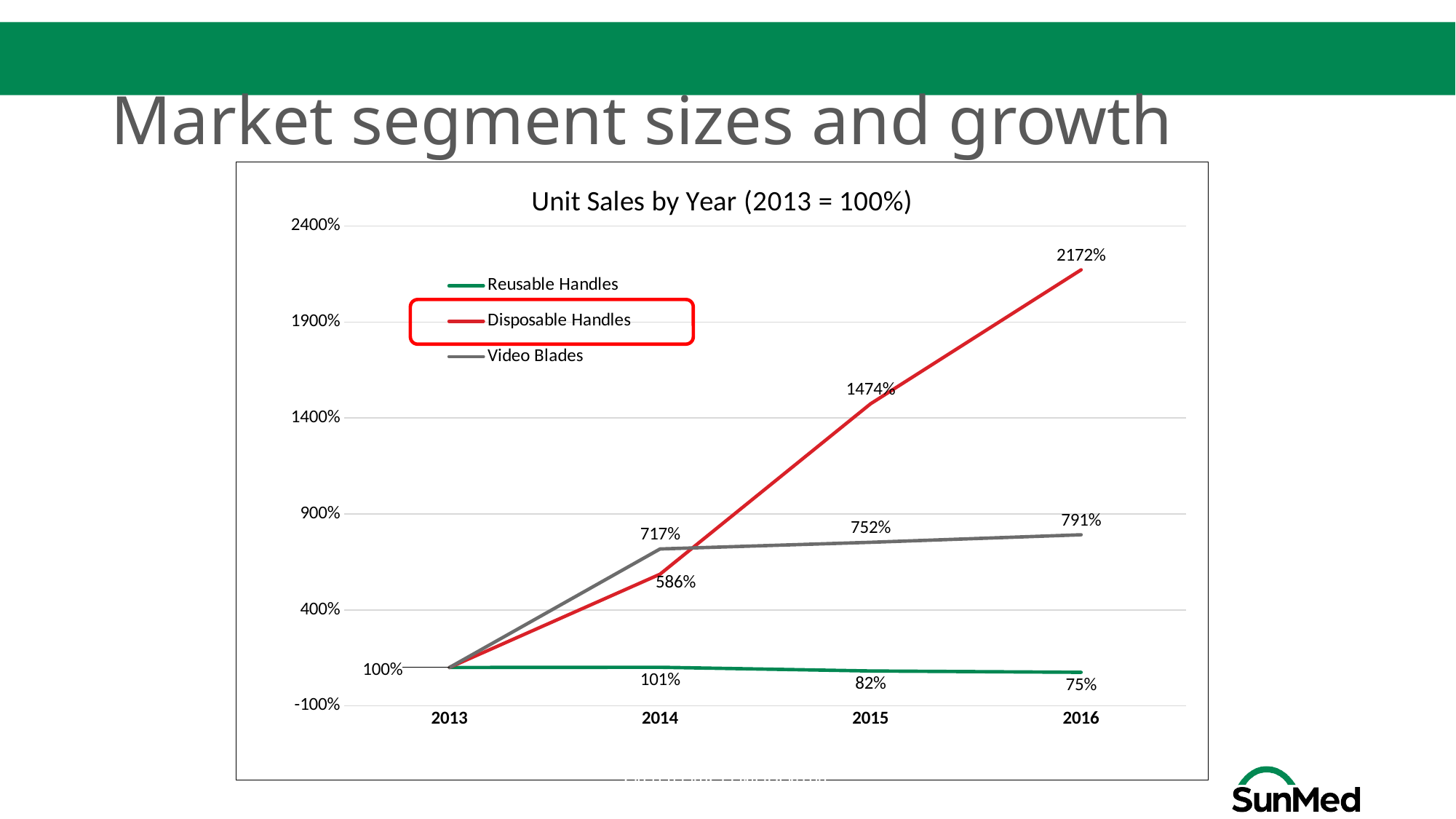
What is the value for Video Blades in 2014? 717% What is the title of the chart? Unit Sales by Year (2013 = 100%) What is the value for Reusable Handles in 2015? 82% How many years are shown on the x axis? 4 What type of chart is shown on the slide? line chart Does the Reusable Handles series rise or fall from 2014 to 2016? fall How many series does the legend list? 3 Which series has the lowest value in 2014? Reusable Handles Which series has the highest value in 2016? Disposable Handles What is the difference between Disposable Handles and Video Blades in 2015? 722% What is the value for Disposable Handles in 2016? 2172% Which is larger in 2014, Video Blades or Disposable Handles? Video Blades